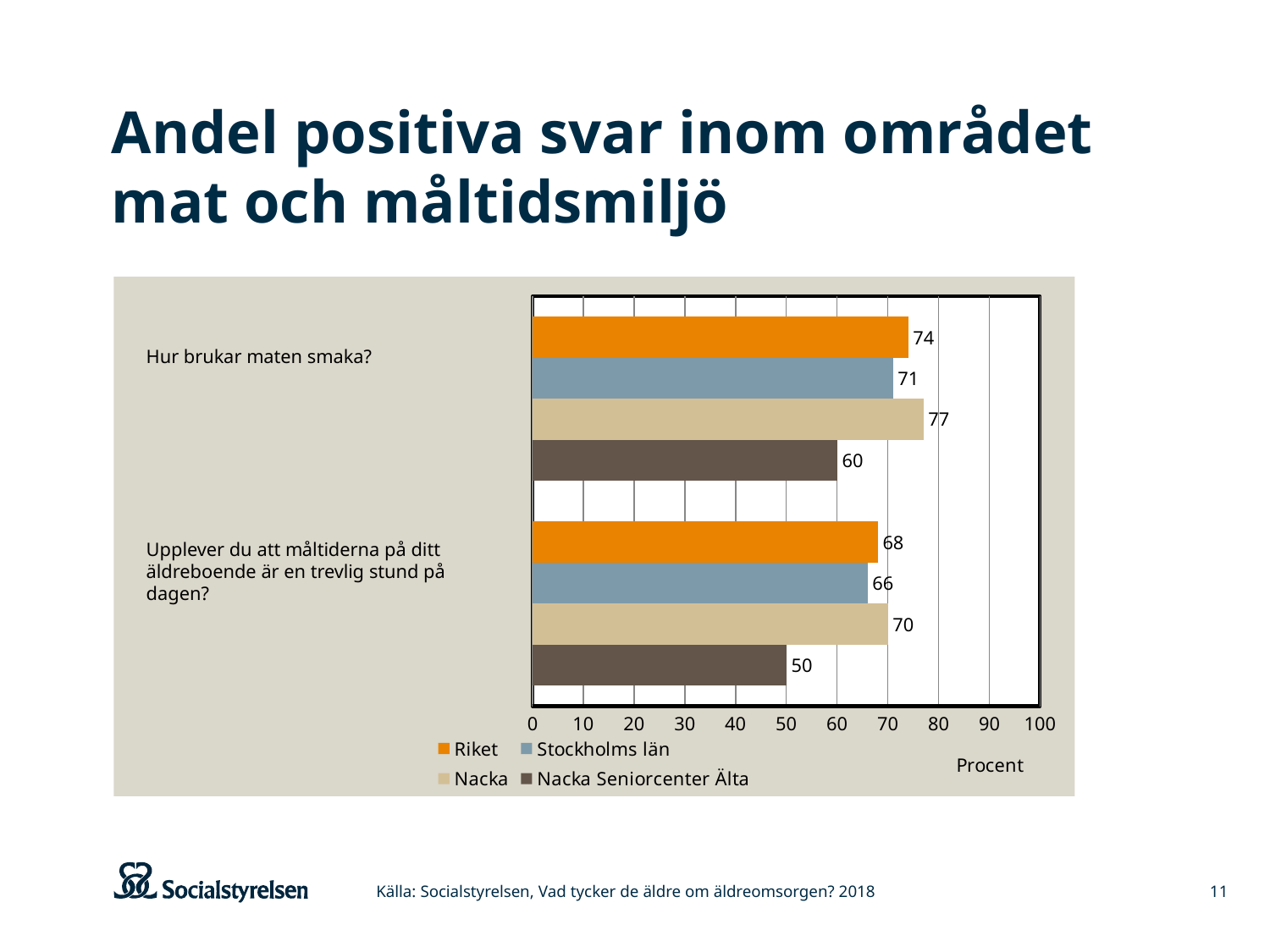
What is the value for Nacka Seniorcenter Älta for the question "Upplever du att måltiderna på ditt äldreboende är en trevlig stund på dagen?"? 50 Which series has the lowest value for the question "Upplever du att måltiderna på ditt äldreboende är en trevlig stund på dagen?"? Nacka Seniorcenter Älta Which is larger for the question "Upplever du att måltiderna på ditt äldreboende är en trevlig stund på dagen?": Riket or Stockholms län? Riket How many questions (categories) are shown on the chart? 2 Which series has the highest value for the question "Hur brukar maten smaka?"? Nacka What is the difference between the Riket value and the Nacka Seniorcenter Älta value for the question "Upplever du att måltiderna på ditt äldreboende är en trevlig stund på dagen?"? 18 What is the difference between the Nacka value and the Nacka Seniorcenter Älta value for the question "Hur brukar maten smaka?"? 17 What is the value for Riket for the question "Hur brukar maten smaka?"? 74 What kind of chart is shown on the slide? Bar chart How many series does the legend list? 4 What is the value for Stockholms län for the question "Hur brukar maten smaka?"? 71 What unit is shown on the horizontal axis of the chart? Procent